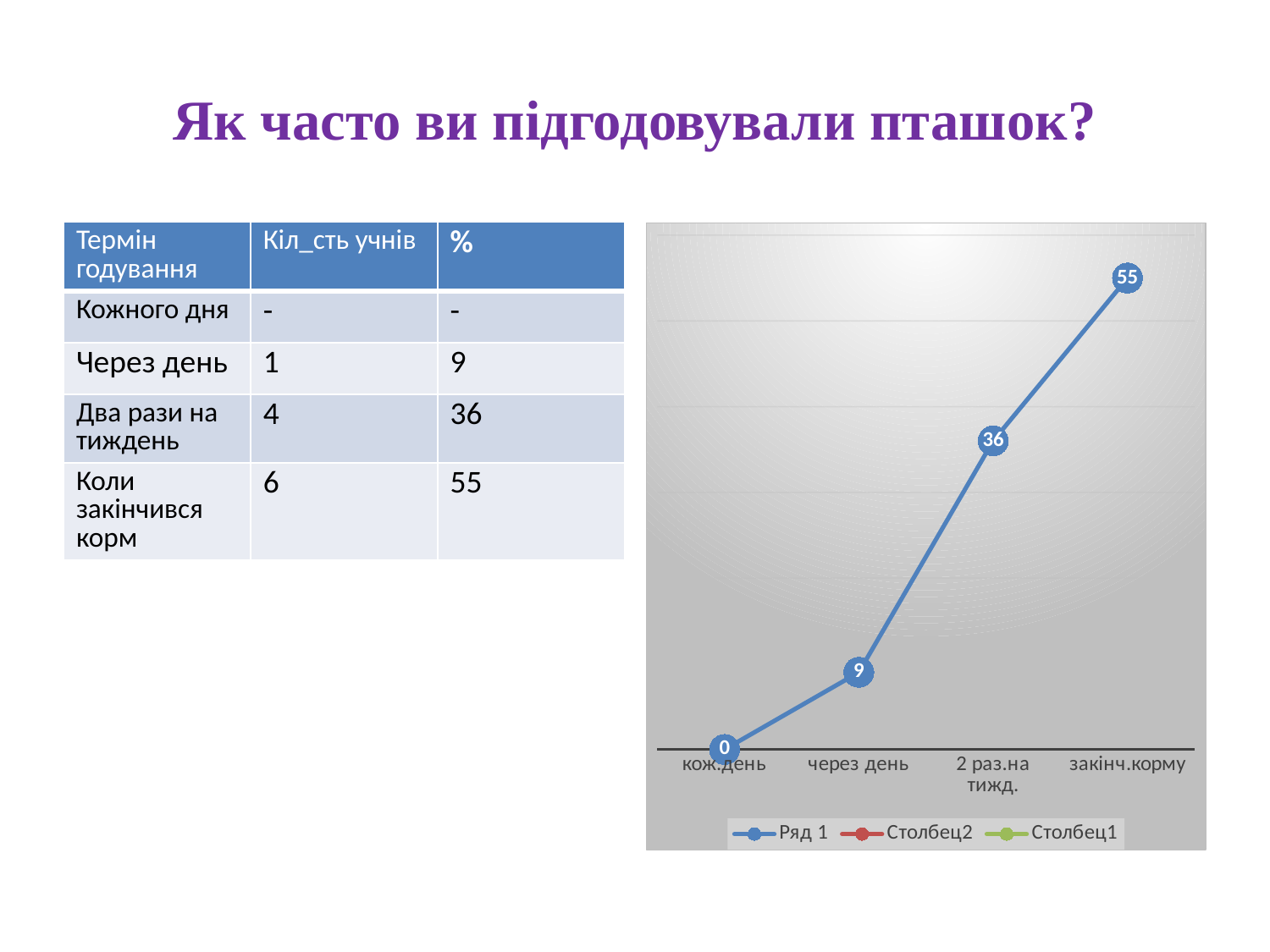
What kind of chart is shown on the slide? line chart What is the value for "через день" on the chart? 9 How many categories are plotted on the chart? 4 What is the difference between the values for "2 раз.на тижд." and "через день"? 27 Which is larger: the value for "через день" or the value for "2 раз.на тижд."? 2 раз.на тижд. What is the value for "кож.день" on the chart? 0 What is the value for "закінч.корму" on the chart? 55 Which category has the highest value on the chart? закінч.корму What is the value for "2 раз.на тижд." on the chart? 36 Which category has the lowest value on the chart? кож.день How many series does the chart legend list? 3 What is the difference between the values for "закінч.корму" and "2 раз.на тижд."? 19